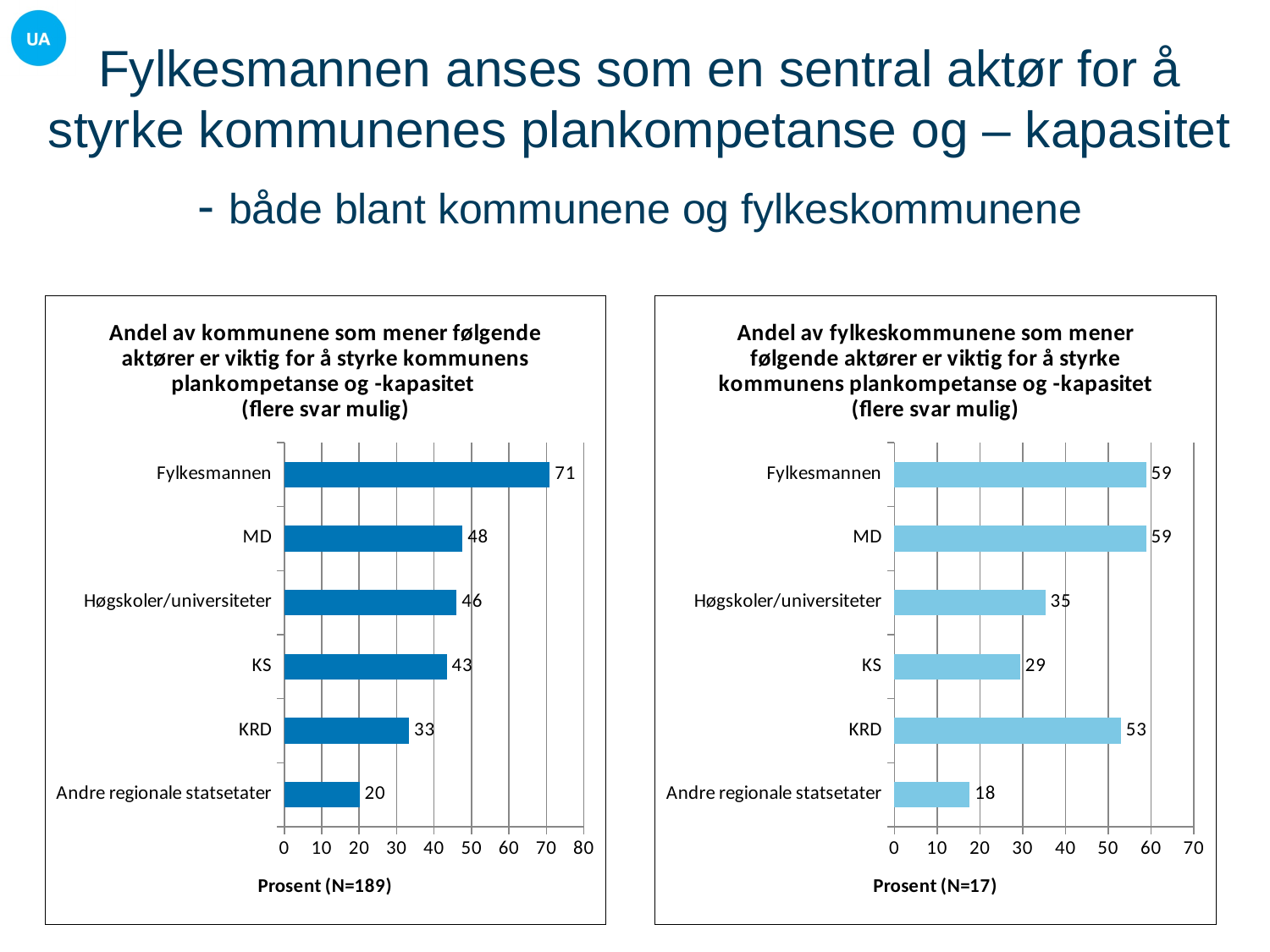
In the right chart (Andel av fylkeskommunene...), which category has the lowest value? Andre regionale statsetater In the left chart (Andel av kommunene...), what is the value for Fylkesmannen? 71 What kind of chart is the right chart (Andel av fylkeskommunene...)? Bar chart In the left chart (Andel av kommunene...), which category has the lowest value? Andre regionale statsetater In the right chart (Andel av fylkeskommunene...), which is larger, the value for Høgskoler/universiteter or the value for KRD? KRD What is the x-axis label of the right chart (Andel av fylkeskommunene...)? Prosent (N=17) In the right chart (Andel av fylkeskommunene...), what is the difference between the values for KRD and KS? 24 In the left chart (Andel av kommunene...), what is the difference between the values for Fylkesmannen and MD? 23 In the left chart (Andel av kommunene...), which category has the highest value? Fylkesmannen In the left chart (Andel av kommunene...), which is larger, the value for KS or the value for KRD? KS How many categories are shown in the left chart (Andel av kommunene...)? 6 In the right chart (Andel av fylkeskommunene...), what is the value for KRD? 53